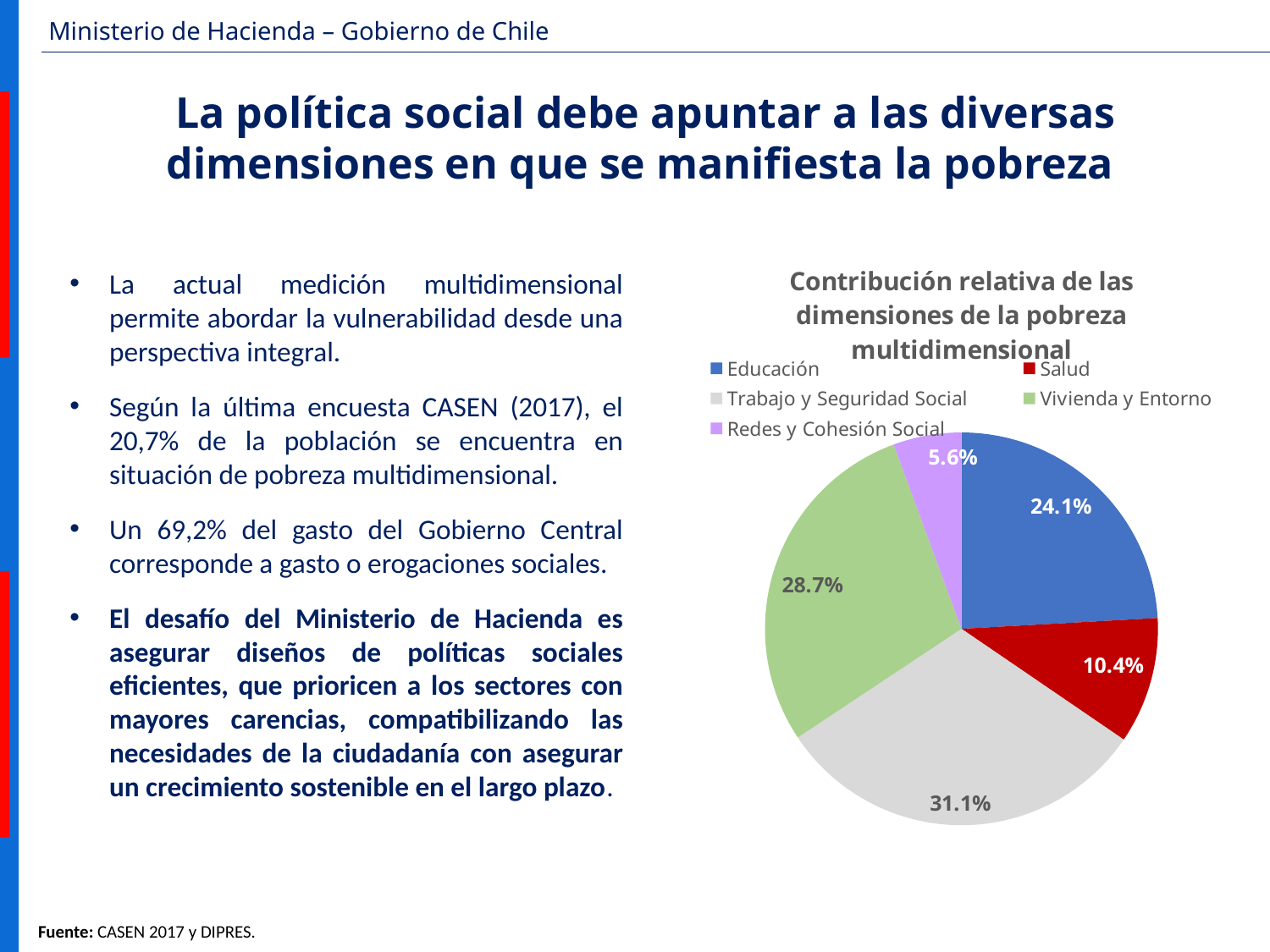
What is the value for Salud? 10.4% What is the difference between the values for Educación and Salud? 13.7% What is the value for Trabajo y Seguridad Social? 31.1% What type of chart is shown on the slide? Pie chart How many dimensions does the legend list? 5 Which dimension has the largest share of the pie? Trabajo y Seguridad Social Which dimension has the smallest share of the pie? Redes y Cohesión Social What is the value for Vivienda y Entorno? 28.7% What is the value for Redes y Cohesión Social? 5.6% Which is larger, the value for Vivienda y Entorno or the value for Educación? Vivienda y Entorno What is the value for Educación? 24.1% What is the title of the chart? Contribución relativa de las dimensiones de la pobreza multidimensional